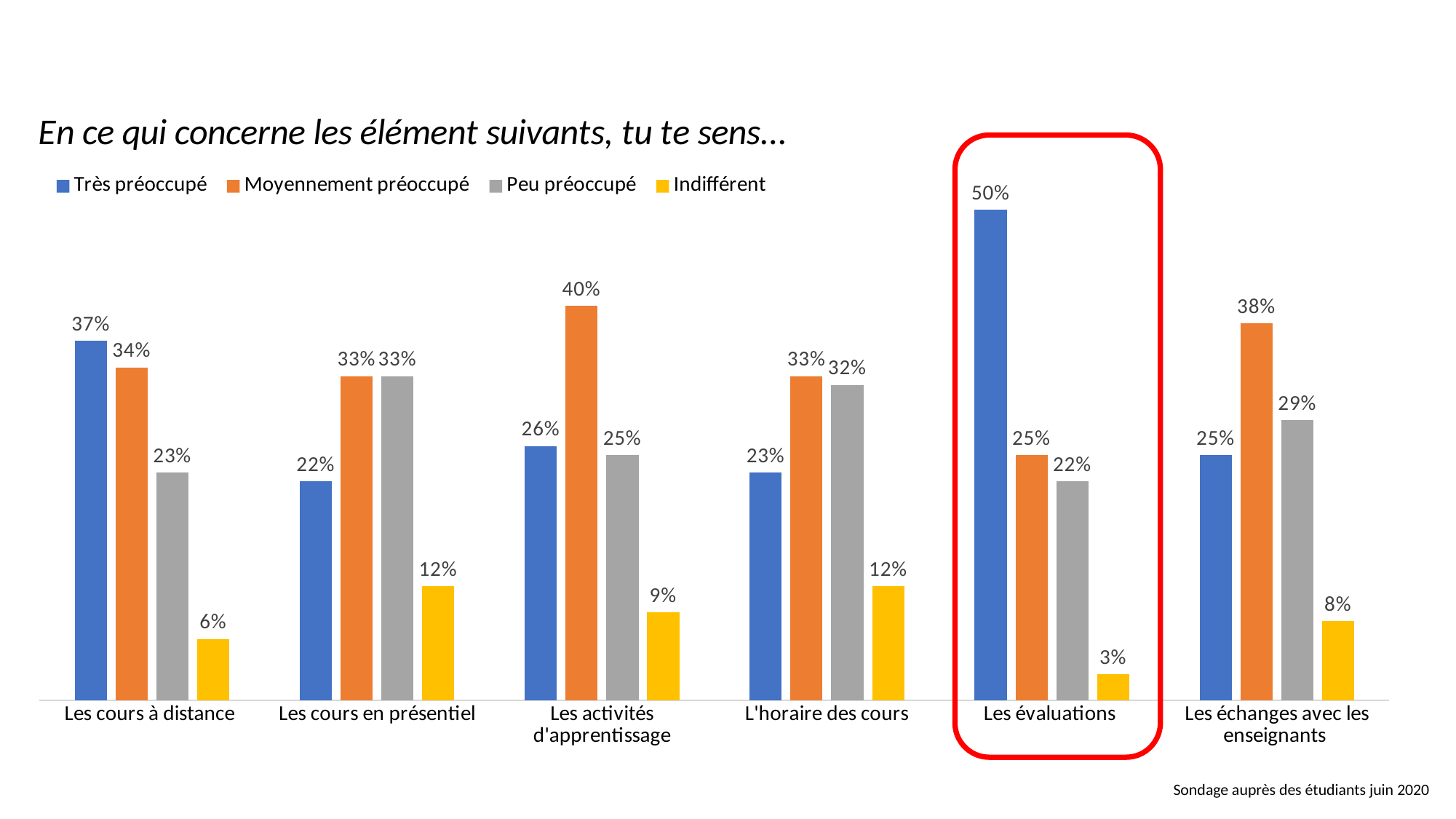
Which is larger: the "Moyennement préoccupé" value for "Les échanges avec les enseignants" or the "Moyennement préoccupé" value for "Les cours à distance"? Les échanges avec les enseignants How many categories are shown on the x axis? 6 Which category is highlighted with a red outline on the slide? Les évaluations What kind of chart is shown on the slide? Bar chart What is the value for "Très préoccupé" for "Les évaluations"? 50% Which category has the lowest value for "Indifférent"? Les évaluations What is the value for "Peu préoccupé" for "Les échanges avec les enseignants"? 29% What is the value for "Moyennement préoccupé" for "Les activités d'apprentissage"? 40% Which category has the highest value for "Très préoccupé"? Les évaluations What is the difference between the "Très préoccupé" value for "Les évaluations" and the "Très préoccupé" value for "Les cours en présentiel"? 28% What is the value for "Indifférent" for "Les cours à distance"? 6% How many series does the legend list? 4